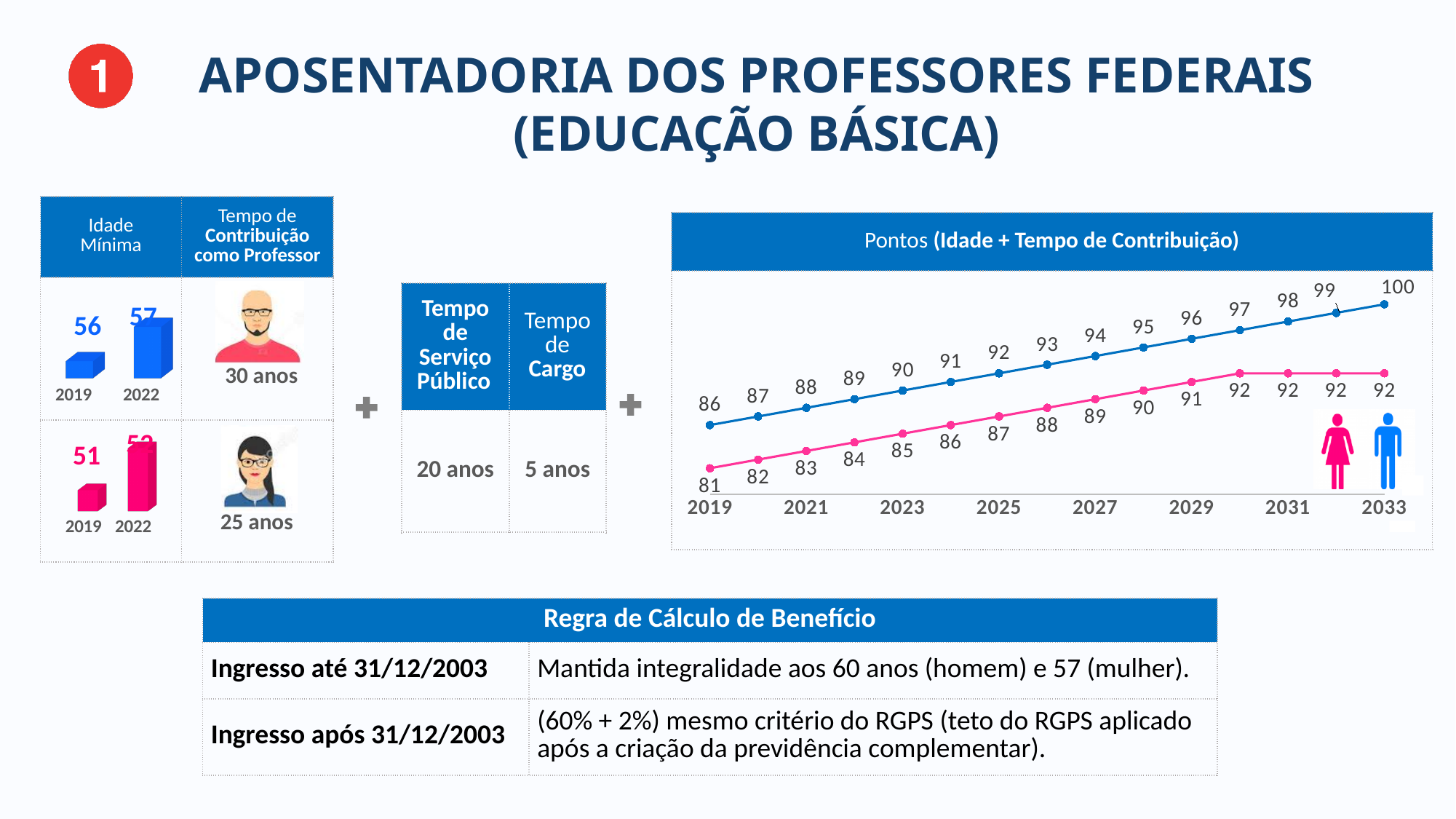
In the 'Pontos' chart, what is the value of the blue line in 2033? 100 What kind of chart is the 'Pontos (Idade + Tempo de Contribuição)' chart? line chart In the 'Idade Mínima' bar chart, what is the blue bar value for 2022? 57 In the 'Pontos' chart, does the blue line rise or fall from 2019 to 2033? rise In the 'Pontos' chart, which line has the higher value in 2025, the blue line or the pink line? blue line In the 'Pontos' chart, what is the value of the blue line in 2019? 86 In the 'Pontos' chart, in which year does the blue line reach its highest value? 2033 In the 'Pontos' chart, what is the value of the pink line in 2033? 92 In the 'Pontos' chart, by how much does the blue line increase from 2019 to 2033? 14 In the 'Pontos' chart, what is the difference between the blue line and the pink line in 2033? 8 In the 'Pontos' chart, what is the value of the pink line in 2019? 81 In the 'Pontos' chart, how many years are plotted along the x axis? 15